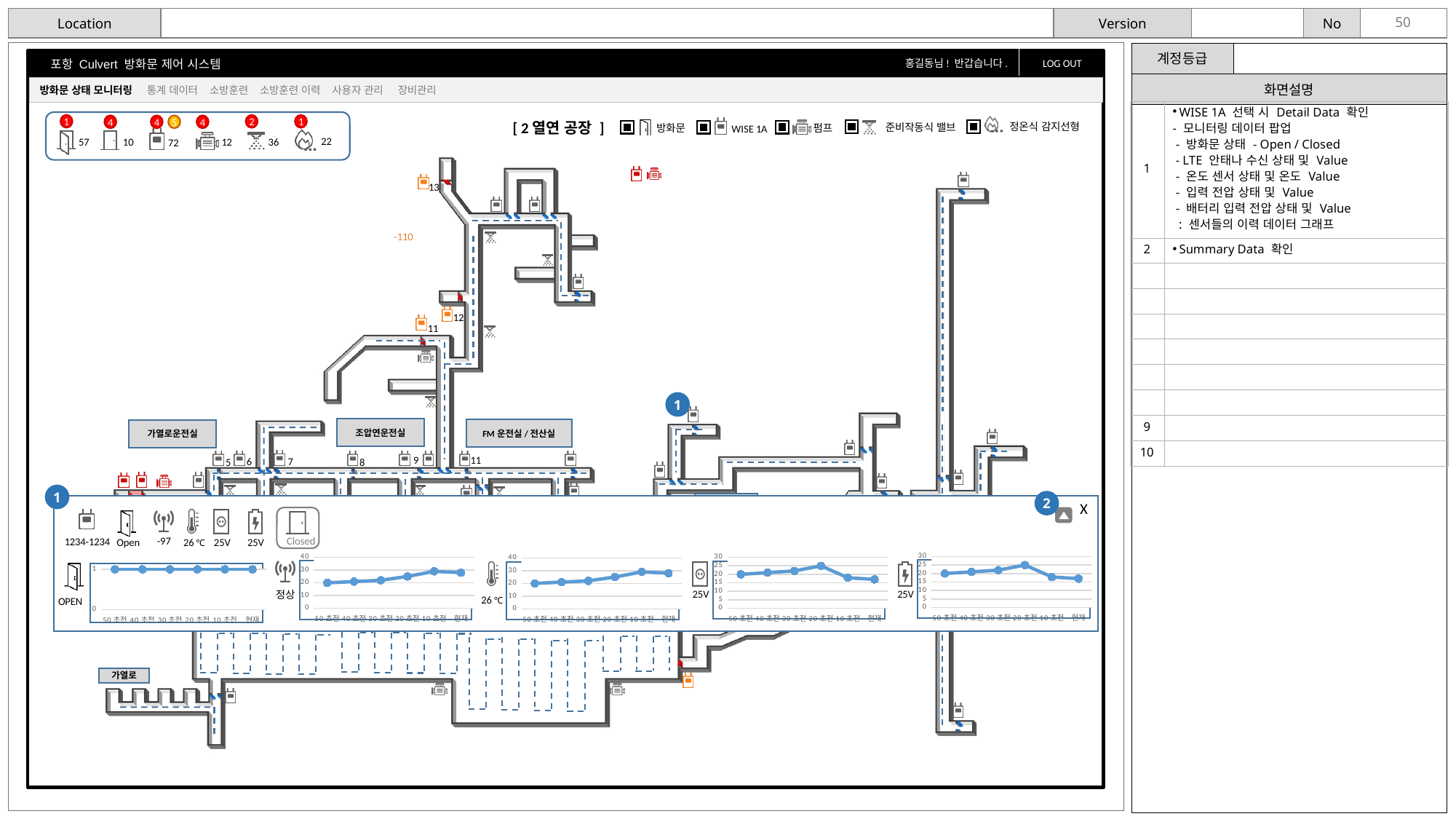
What kind of chart is the leftmost chart in the detail panel (next to the OPEN door icon)? line chart On the temperature chart (labelled 26 ℃), is the value at 현재 greater or less than 20? greater On the fourth chart from the left (voltage, 25V), is the value at 현재 greater or less than 25? less What is the label of the last point on the x axis of the temperature chart (labelled 26 ℃)? 현재 On the leftmost chart (door, OPEN), is the value at 현재 greater or less than 0? greater How many small charts are shown in the detail panel at the bottom of the screen? 5 What is the highest tick shown on the y axis of the antenna chart (labelled 정상)? 40 How many data points are plotted on the antenna chart (labelled 정상) in the detail panel? 6 On the antenna chart (labelled 정상), do the values rise or fall from 50 초전 to 현재? rise On the temperature chart (labelled 26 ℃), do the values rise or fall from 50 초전 to 현재? rise